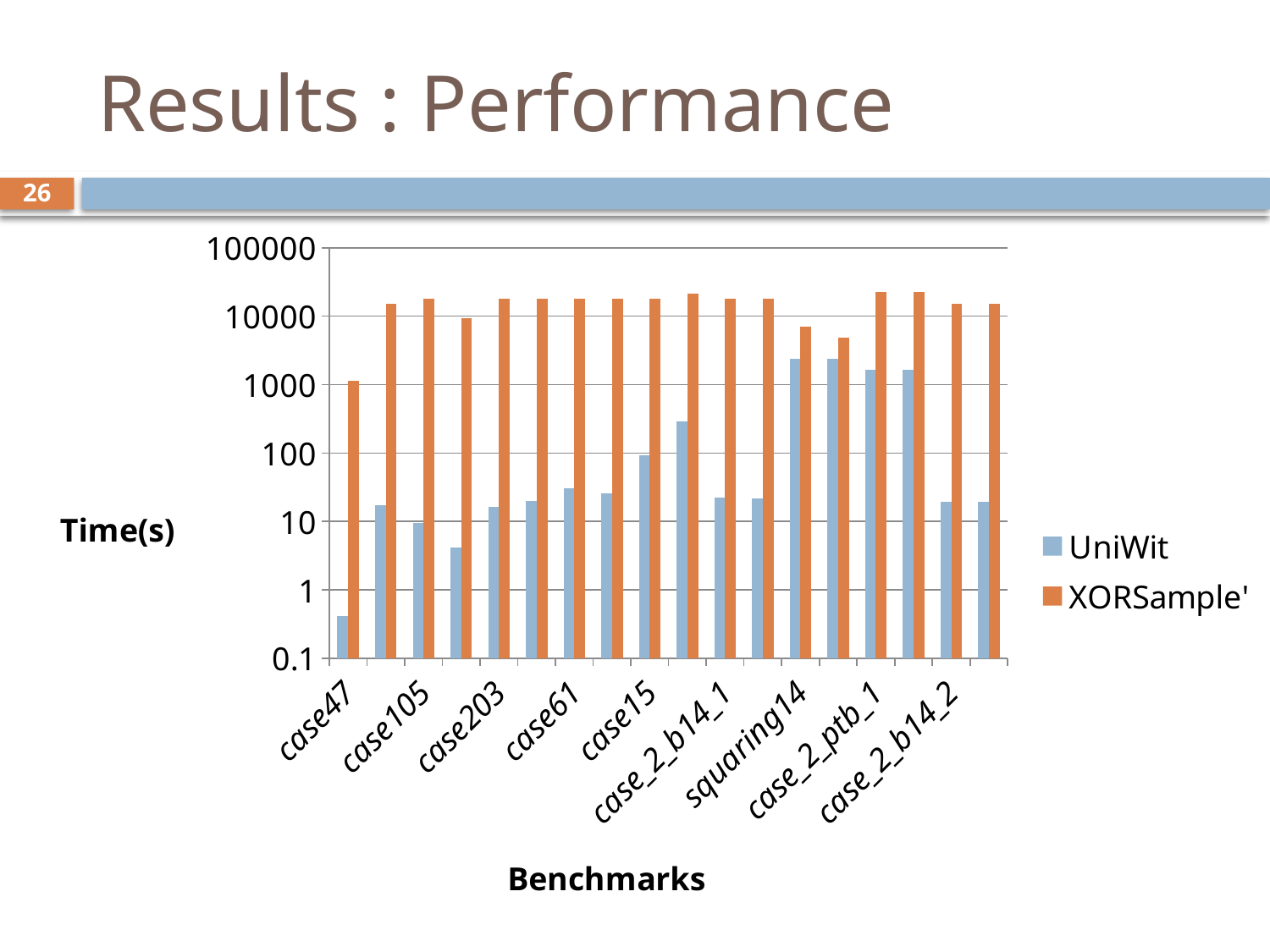
How many series does the legend list? 2 Is the XORSample' value for squaring14 greater or less than 10000? less What is the label on the vertical axis? Time(s) Is the XORSample' value for case105 greater or less than 10000? greater Is the UniWit value for case61 greater or less than 10? greater What kind of chart is shown on the slide? bar chart For case47, which series has the larger value, UniWit or XORSample'? XORSample' For case_2_ptb_1, which series has the larger value, UniWit or XORSample'? XORSample' Which series is shown in orange in the legend? XORSample'